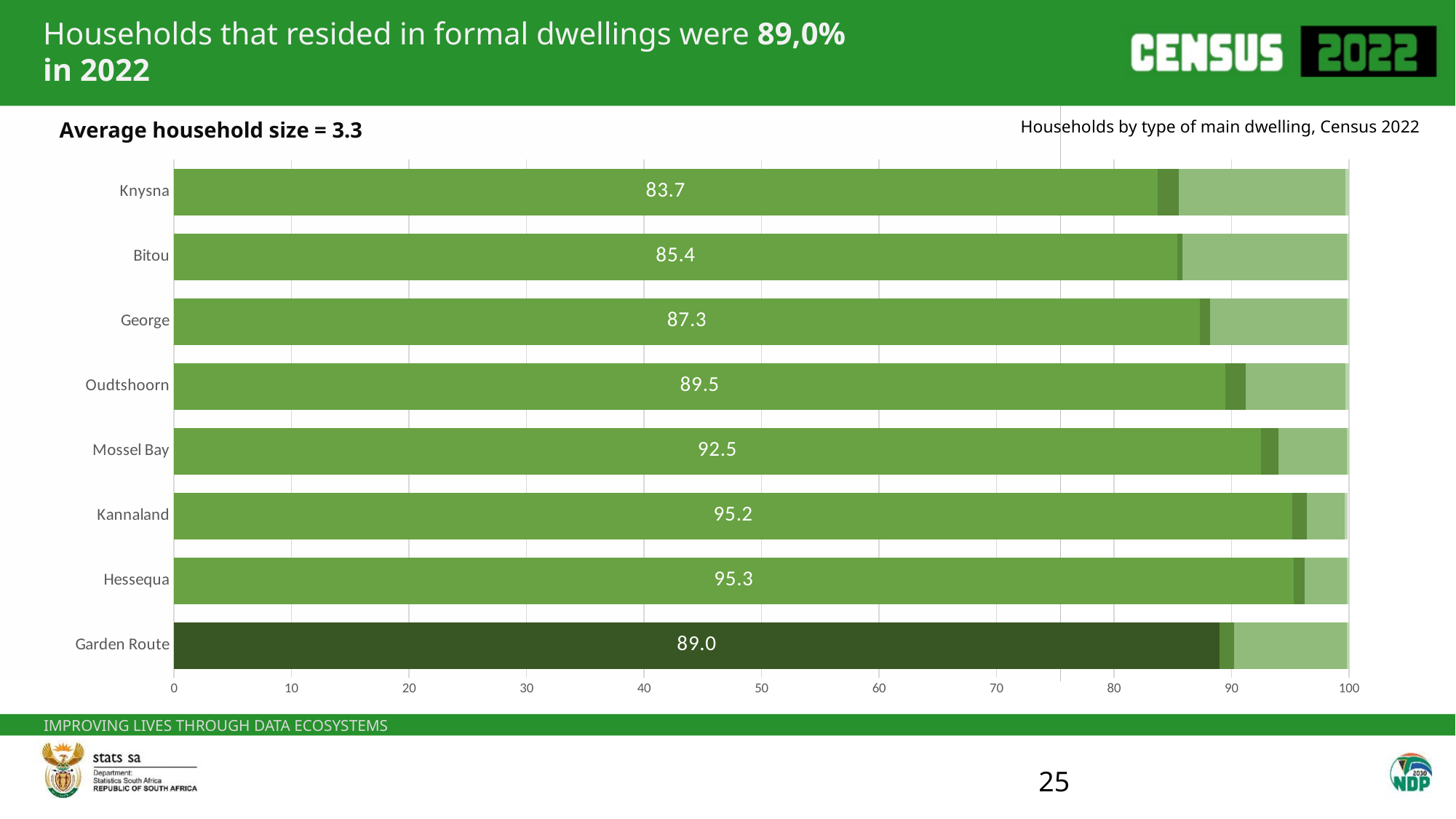
What is the labelled value for Oudtshoorn? 89.5 Which municipality has the lowest labelled value? Knysna What is the difference between the labelled values for Mossel Bay and Knysna? 8.8 What is the labelled value for Knysna? 83.7 What is the labelled value for Garden Route? 89.0 What is the title of the chart? Households by type of main dwelling, Census 2022 How many municipalities are shown on the chart? 8 What kind of chart is shown on the slide? Bar chart Which has the larger labelled value, Oudtshoorn or George? Oudtshoorn What is the difference between the labelled values for George and Bitou? 1.9 What is the labelled value for Mossel Bay? 92.5 Which municipality has the highest labelled value? Hessequa